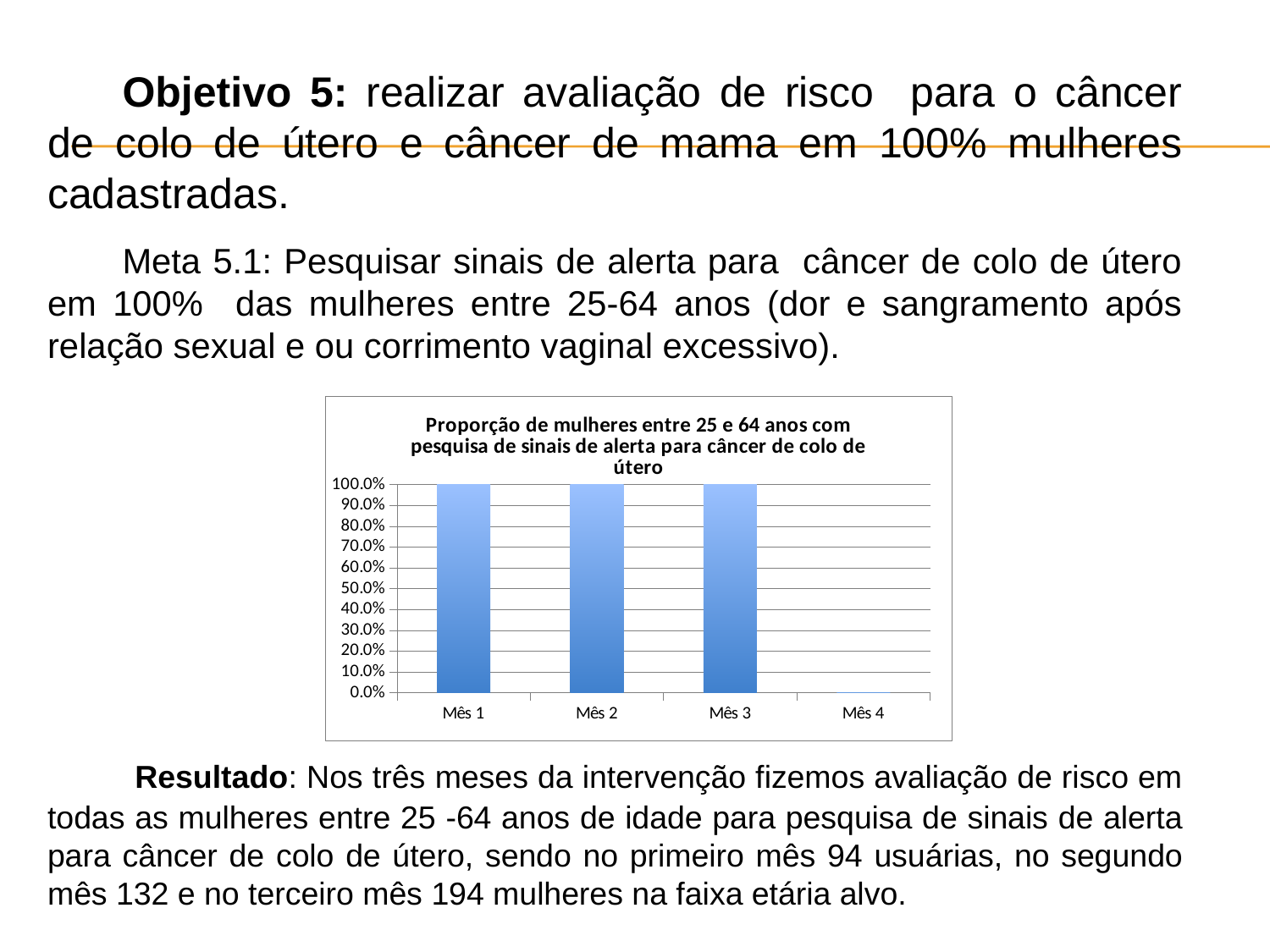
What is the highest value shown on the y axis of the chart? 100.0% Is the value for Mês 2 greater or less than 50.0%? greater What is the value for Mês 4 in the chart? 0.0% What kind of chart is shown on the slide? bar chart Is the value for Mês 4 greater or less than 10.0%? less Which category has the lowest value in the chart? Mês 4 What is the value for Mês 3 in the chart? 100.0% What is the title of the chart? Proporção de mulheres entre 25 e 64 anos com pesquisa de sinais de alerta para câncer de colo de útero What is the difference between the value for Mês 1 and the value for Mês 4? 100.0% What is the value for Mês 1 in the chart? 100.0% How many categories are shown on the x axis of the chart? 4 Which is larger, the value for Mês 3 or the value for Mês 4? Mês 3